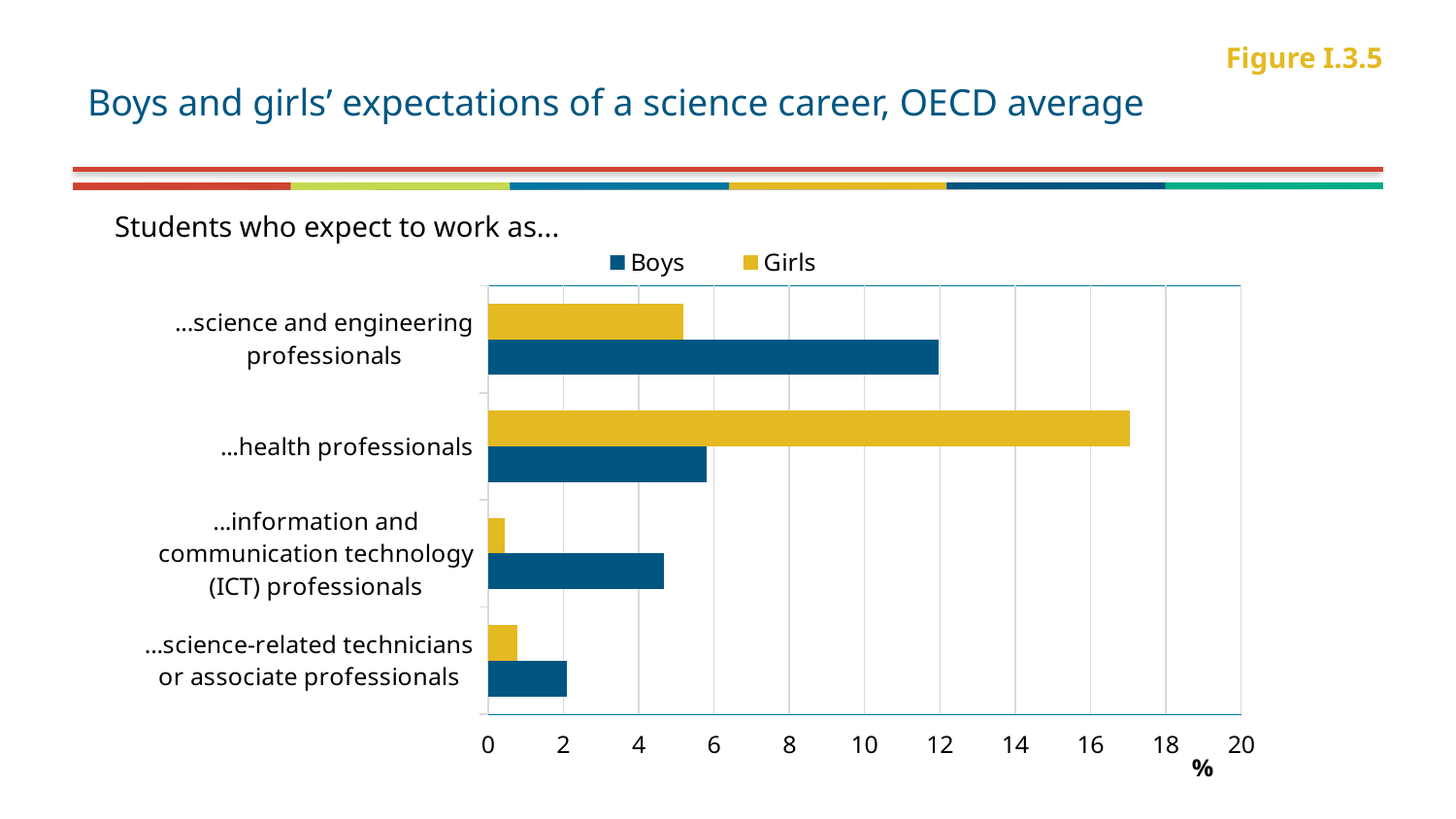
Which career category has the highest value for Boys? ...science and engineering professionals Is the value for Boys who expect to work as ICT professionals greater or less than 6? less Which career category has the highest value for Girls? ...health professionals For health professionals, which is larger, the value for Boys or the value for Girls? Girls Is the value for Girls who expect to work as health professionals greater or less than 16? greater How many career categories are shown on the chart? 4 Which career category has the lowest value for Girls? ...information and communication technology (ICT) professionals How many series does the legend list? 2 For science and engineering professionals, which is larger, the value for Boys or the value for Girls? Boys Which career category has the lowest value for Boys? ...science-related technicians or associate professionals What is the title of the chart on the slide? Boys and girls' expectations of a science career, OECD average What kind of chart is shown on the slide? bar chart